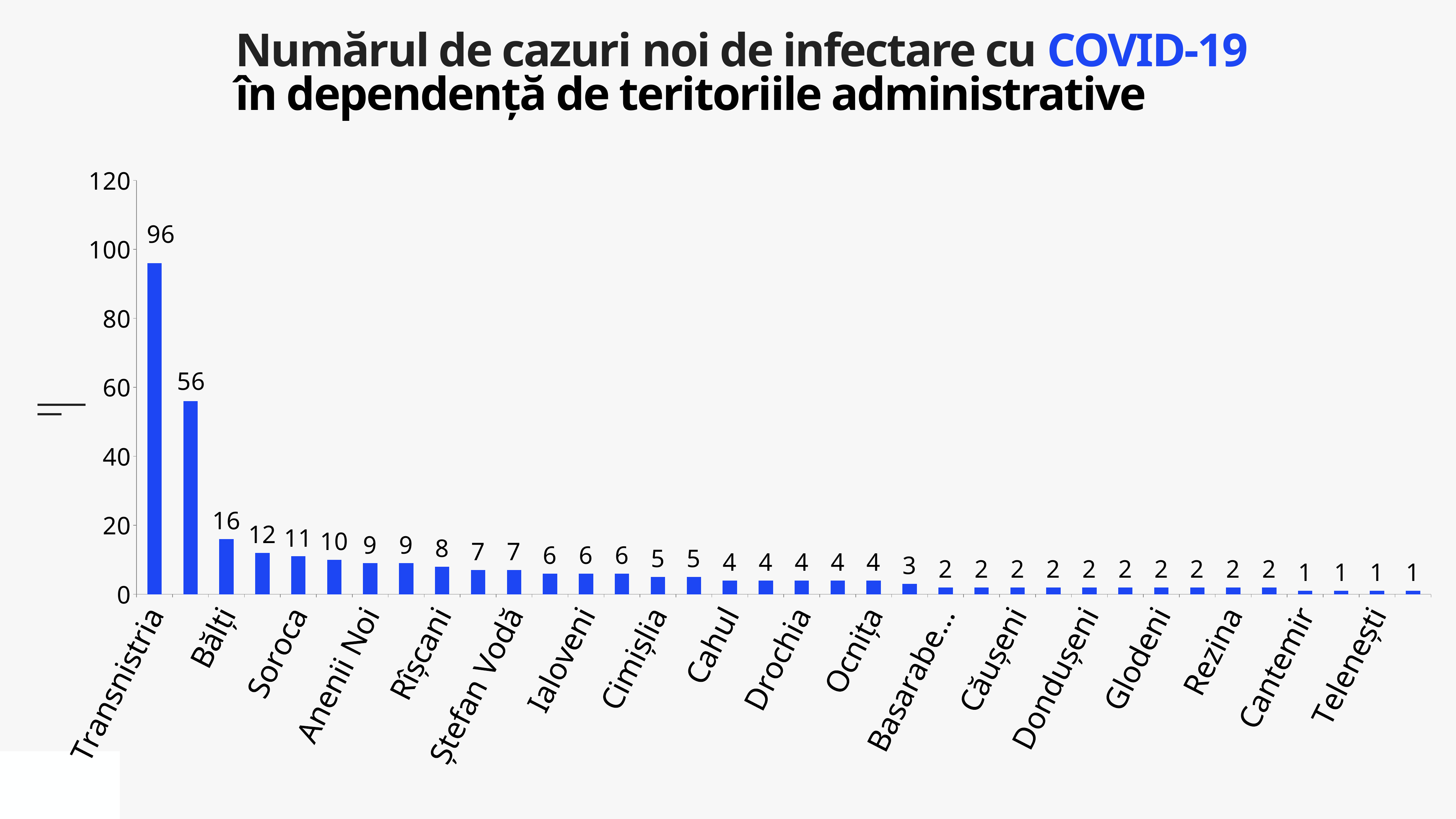
Which territory has the highest number of new cases? Transnistria Is the value for Transnistria greater or less than 80? greater What is the difference between the values for Transnistria and Bălți? 80 What is the highest value shown on the vertical axis? 120 What is the value for Soroca? 11 What is the value for Transnistria? 96 What is the value for Telenești? 1 What kind of chart is shown on the slide? bar chart What is the value for Bălți? 16 Which is larger, the value for Transnistria or the value for Soroca? Transnistria Do the values rise or fall from left to right along the x axis? fall What is the title of the chart? Numărul de cazuri noi de infectare cu COVID-19 în dependență de teritoriile administrative